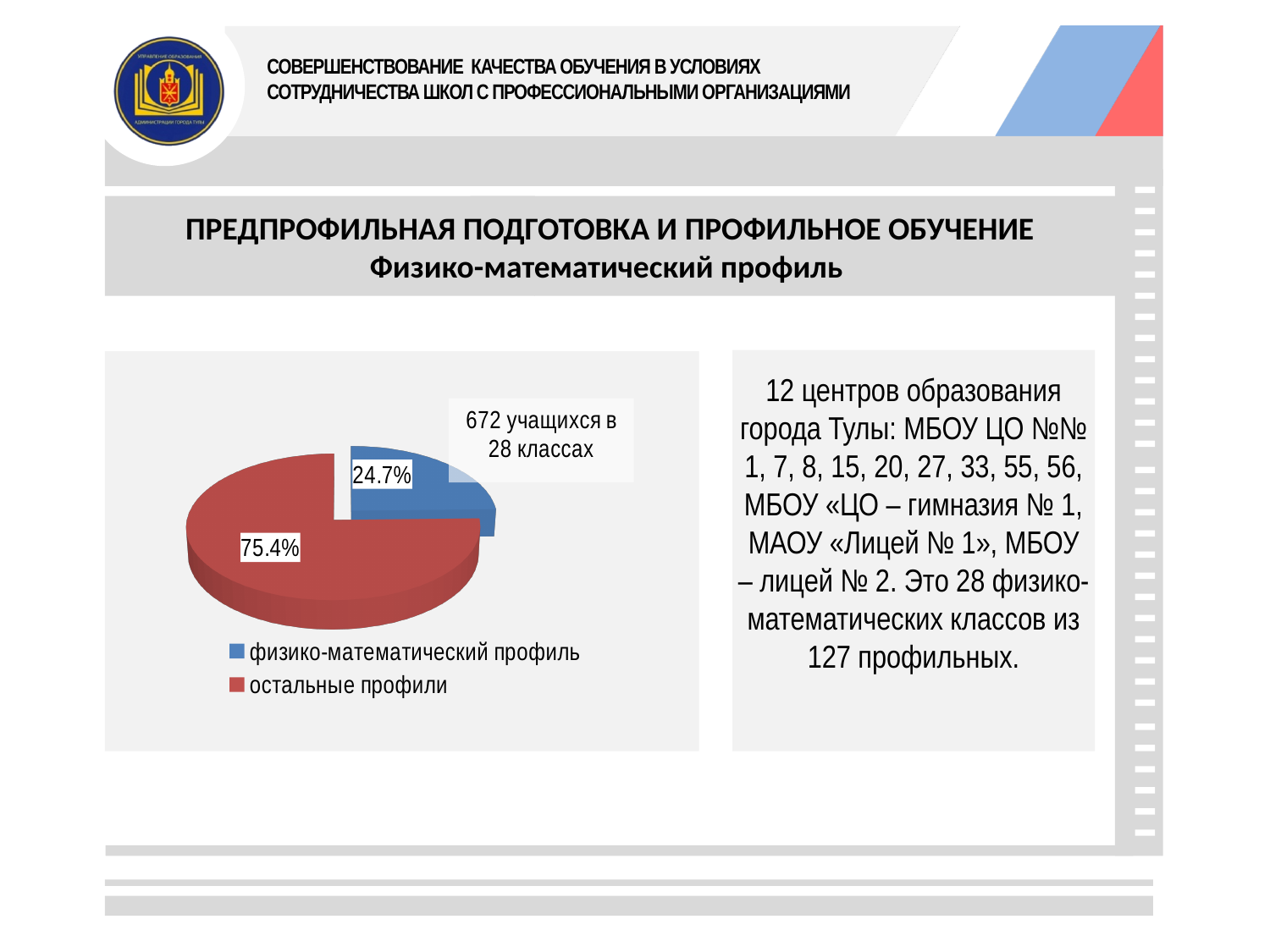
Which is larger: the slice for физико-математический профиль or the slice for остальные профили? остальные профили What share of the pie does the slice for физико-математический профиль represent? 24.7% What colour is the slice for физико-математический профиль? blue Which slice of the pie is the largest? остальные профили What is the difference in percentage points between the остальные профили slice and the физико-математический профиль slice? 50.7 How many slices does the pie chart have? 2 What does the text box next to the pie chart say? 672 учащихся в 28 классах What kind of chart is shown on the slide? pie chart Which slice of the pie is the smallest? физико-математический профиль How many entries does the chart legend list? 2 What share of the pie does the slice for остальные профили represent? 75.4% Is the value for физико-математический профиль greater or less than 50%? less